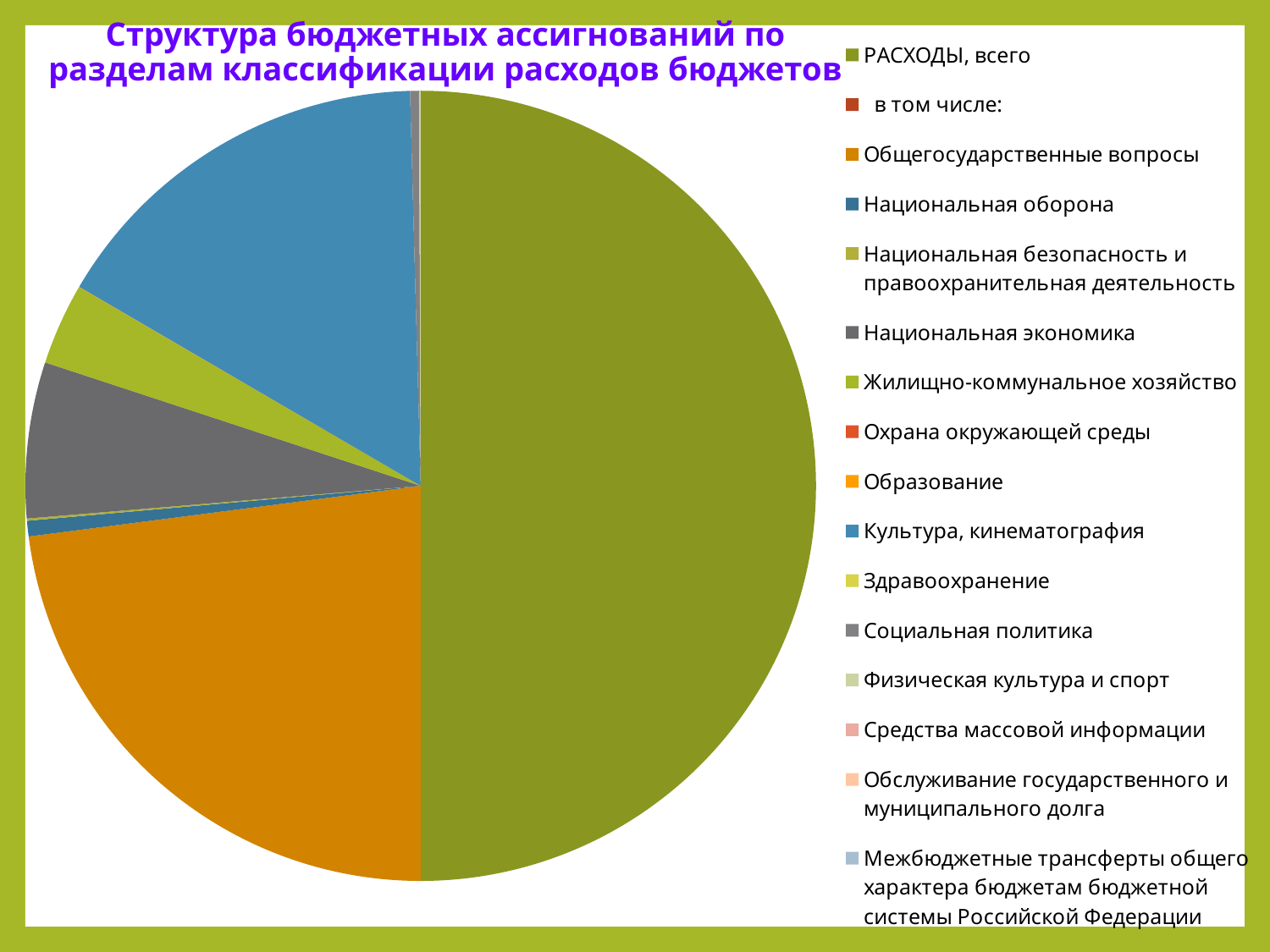
What kind of chart is shown on the slide? pie chart Which slice is larger: Общегосударственные вопросы or Национальная экономика? Общегосударственные вопросы Which slice is larger: РАСХОДЫ, всего or Общегосударственные вопросы? РАСХОДЫ, всего What colour is the slice for Общегосударственные вопросы? orange Which slice is larger: Национальная экономика or Жилищно-коммунальное хозяйство? Национальная экономика What is the title of the chart? Структура бюджетных ассигнований по разделам классификации расходов бюджетов How many entries does the chart legend list? 16 Which category has the largest slice of the pie? РАСХОДЫ, всего